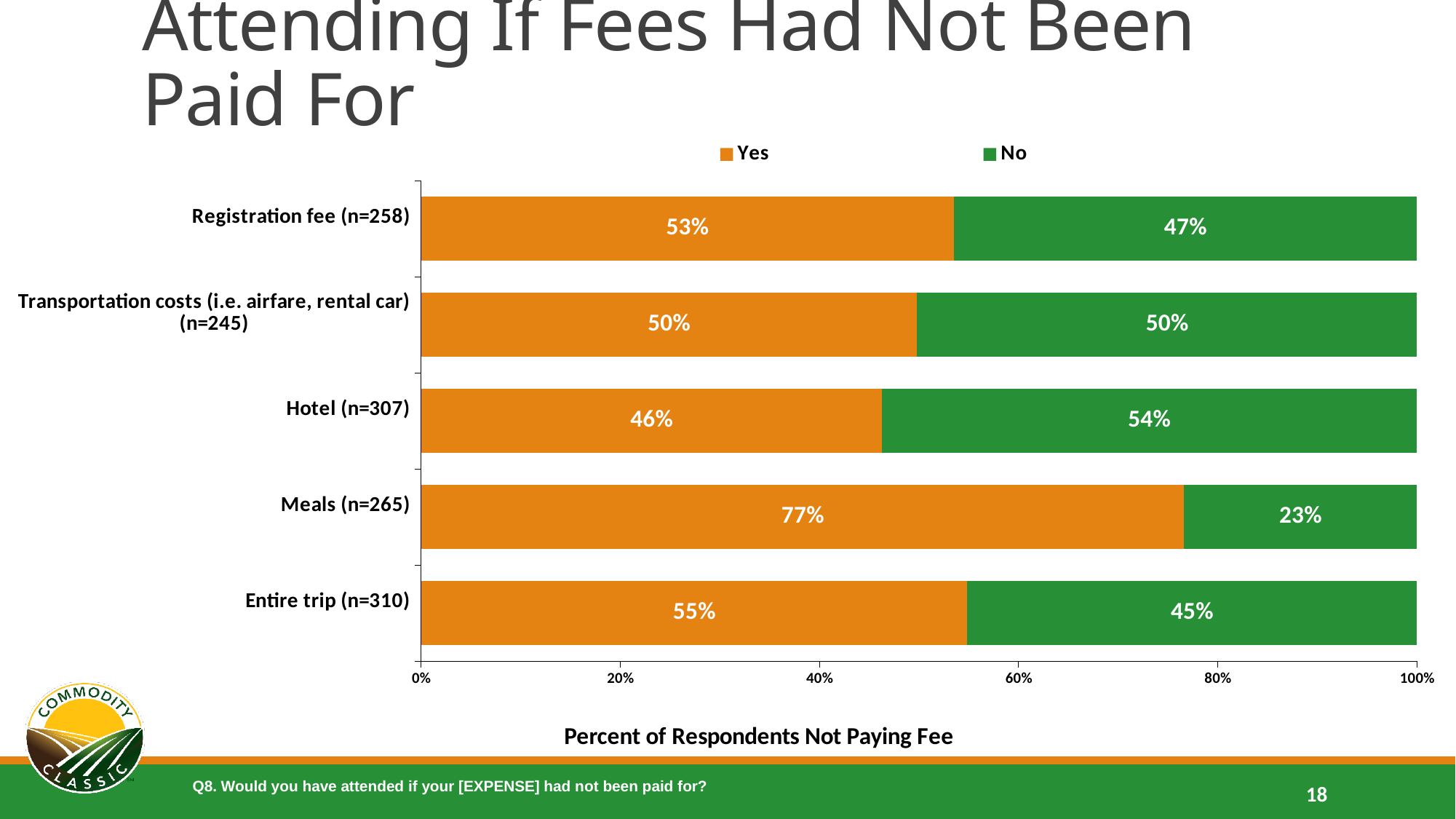
What percentage of respondents answered No for Hotel (n=307)? 54% How many series does the legend list? 2 Is the Yes percentage larger for Entire trip (n=310) or for Hotel (n=307)? Entire trip (n=310) What kind of chart is shown on the slide? Stacked bar chart What percentage of respondents answered Yes for Meals (n=265)? 77% What is the No value for Entire trip (n=310)? 45% What is the difference between the Yes and No percentages for Meals (n=265)? 54% What is the Yes value for Registration fee (n=258)? 53% Which category has the lowest Yes percentage? Hotel (n=307) How many categories are shown on the chart? 5 What is the x-axis title of the chart? Percent of Respondents Not Paying Fee Which category has the highest Yes percentage? Meals (n=265)